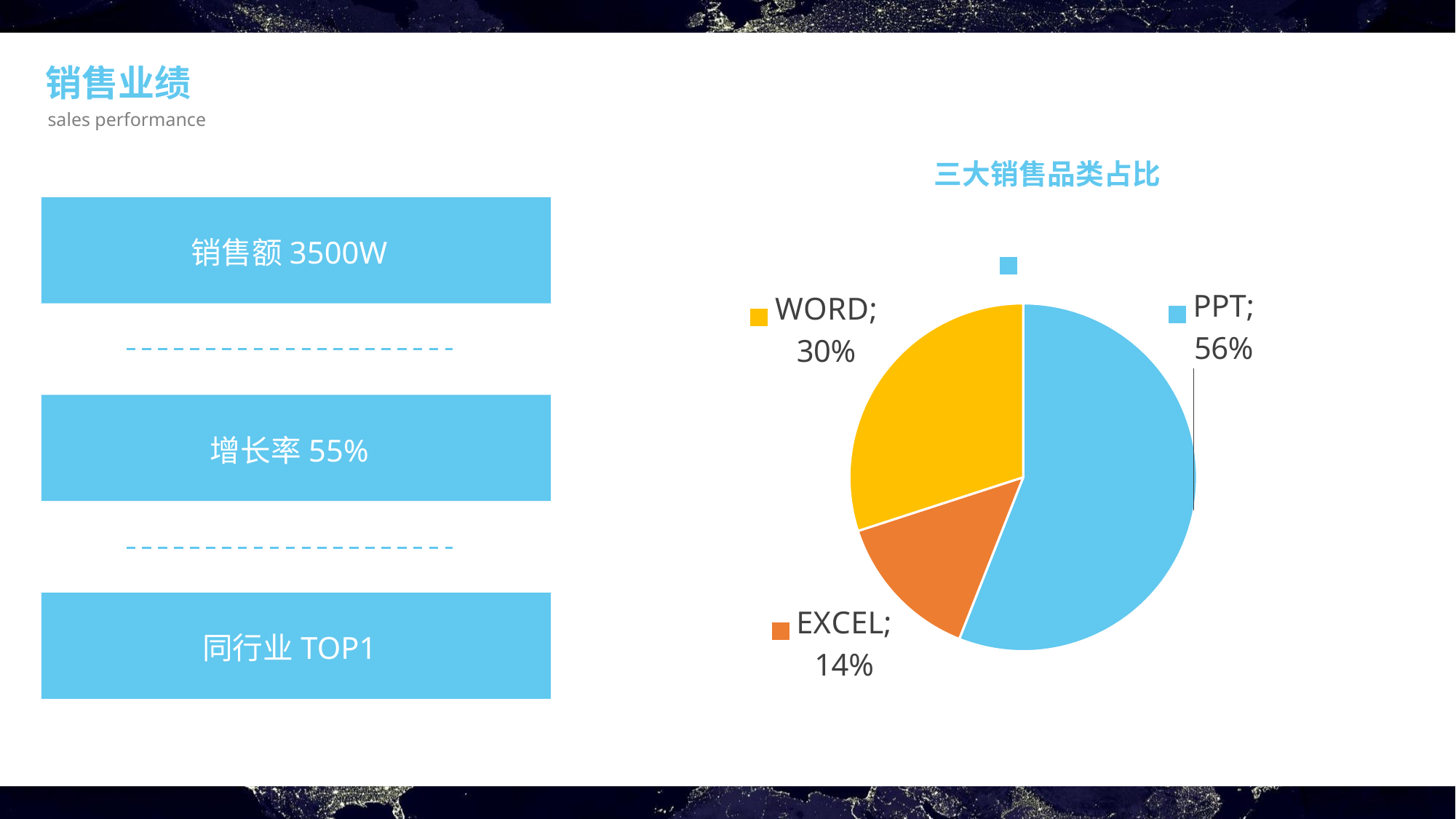
Which category has the smallest share of the pie? EXCEL Which category has the largest share of the pie? PPT What share of the pie does PPT account for? 56% Which is larger, the WORD share or the EXCEL share? WORD What colour is the EXCEL slice of the pie? orange What is the difference in percentage points between the PPT share and the WORD share? 26 How many slices does the pie chart have? 3 What kind of chart is shown on the slide? pie chart What share of the pie does EXCEL account for? 14% Is the PPT share greater or less than 50%? greater What is the title of the pie chart? 三大销售品类占比 What share of the pie does WORD account for? 30%